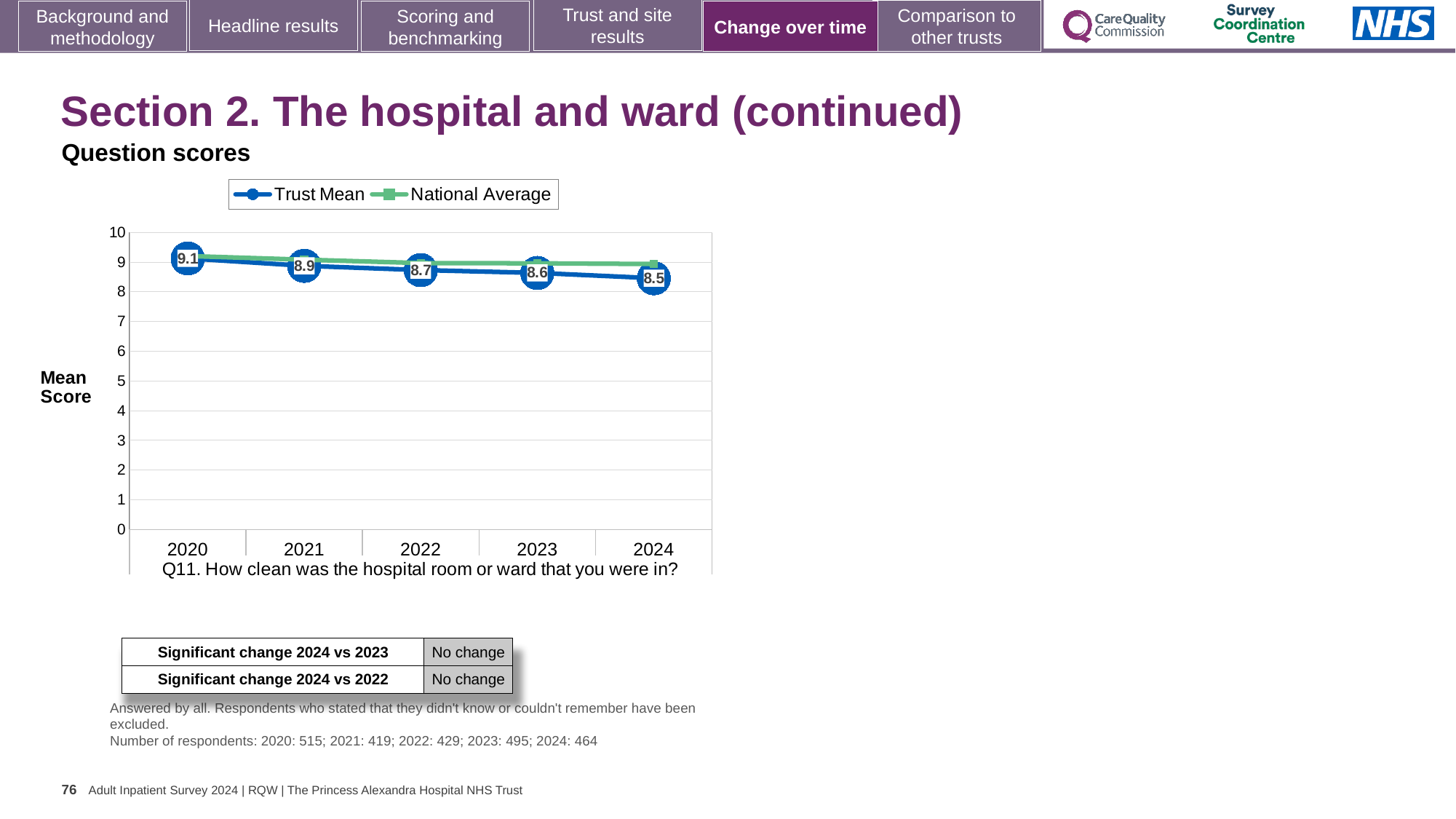
Is the Trust Mean higher in 2021 or in 2023? 2021 Does the Trust Mean rise or fall from 2020 to 2024? fall How many series does the legend list? 2 How many years are shown on the x axis? 5 What is the Trust Mean for 2024? 8.5 What is the Trust Mean for 2020? 9.1 In which year is the Trust Mean lowest? 2024 What is the difference between the Trust Mean in 2020 and in 2024? 0.6 In which year is the Trust Mean highest? 2020 Is the National Average for 2024 greater or less than 8? greater What is the Trust Mean for 2022? 8.7 In 2024, which is higher, the Trust Mean or the National Average? National Average